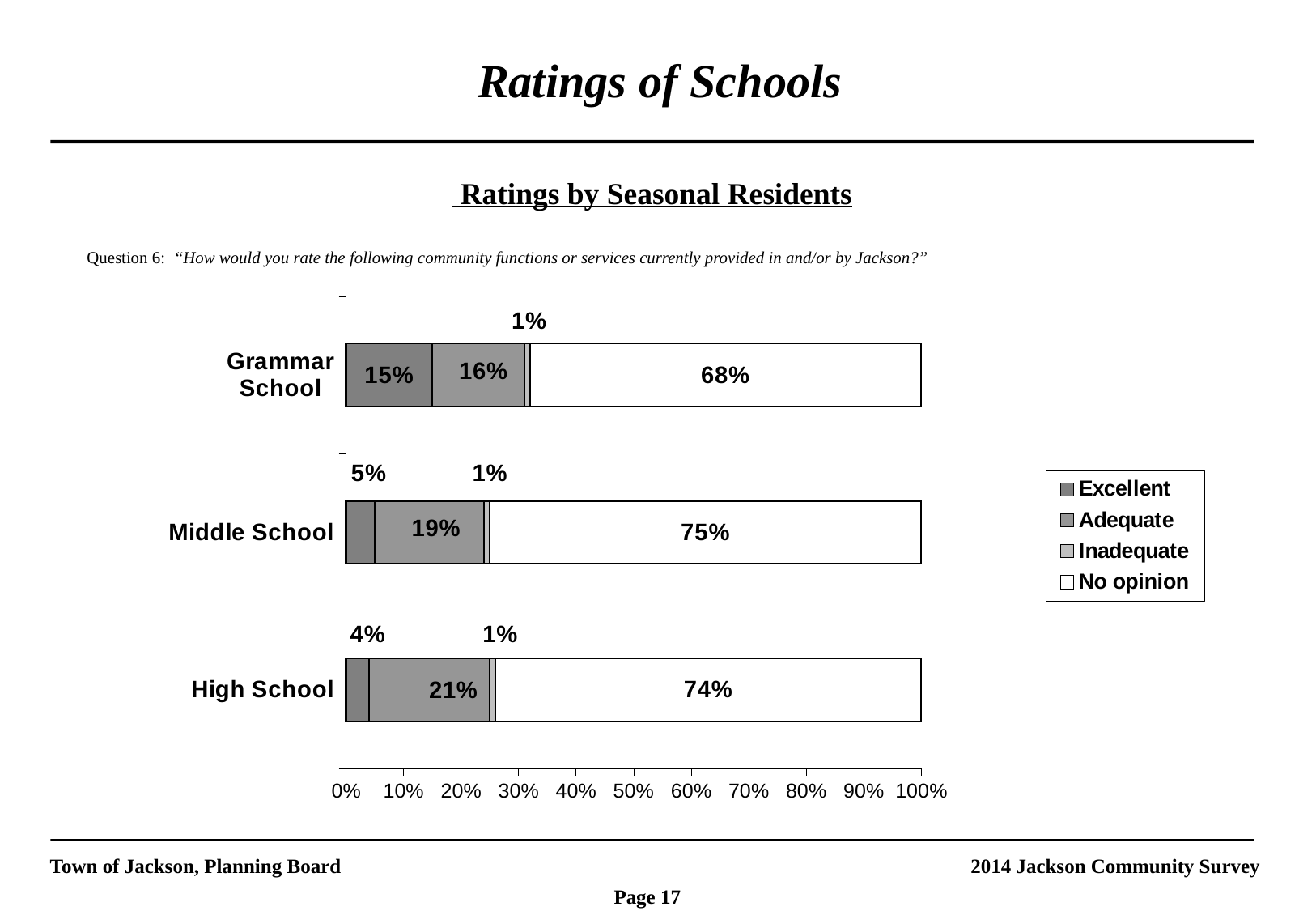
What is the No opinion value for Middle School? 75% What is the Excellent value for Grammar School? 15% Which school has the highest Excellent rating? Grammar School What kind of chart is shown on the slide? Stacked bar chart What is the Adequate value for High School? 21% What is the total of the stacked bar for Middle School? 100% How many schools are shown on the chart? 3 Which is larger, the Excellent value for Middle School or for High School? Middle School How many series does the legend list? 4 What is the difference between the Adequate values for High School and Grammar School? 5% Which school has the lowest No opinion share? Grammar School Which legend entry is shown in white? No opinion